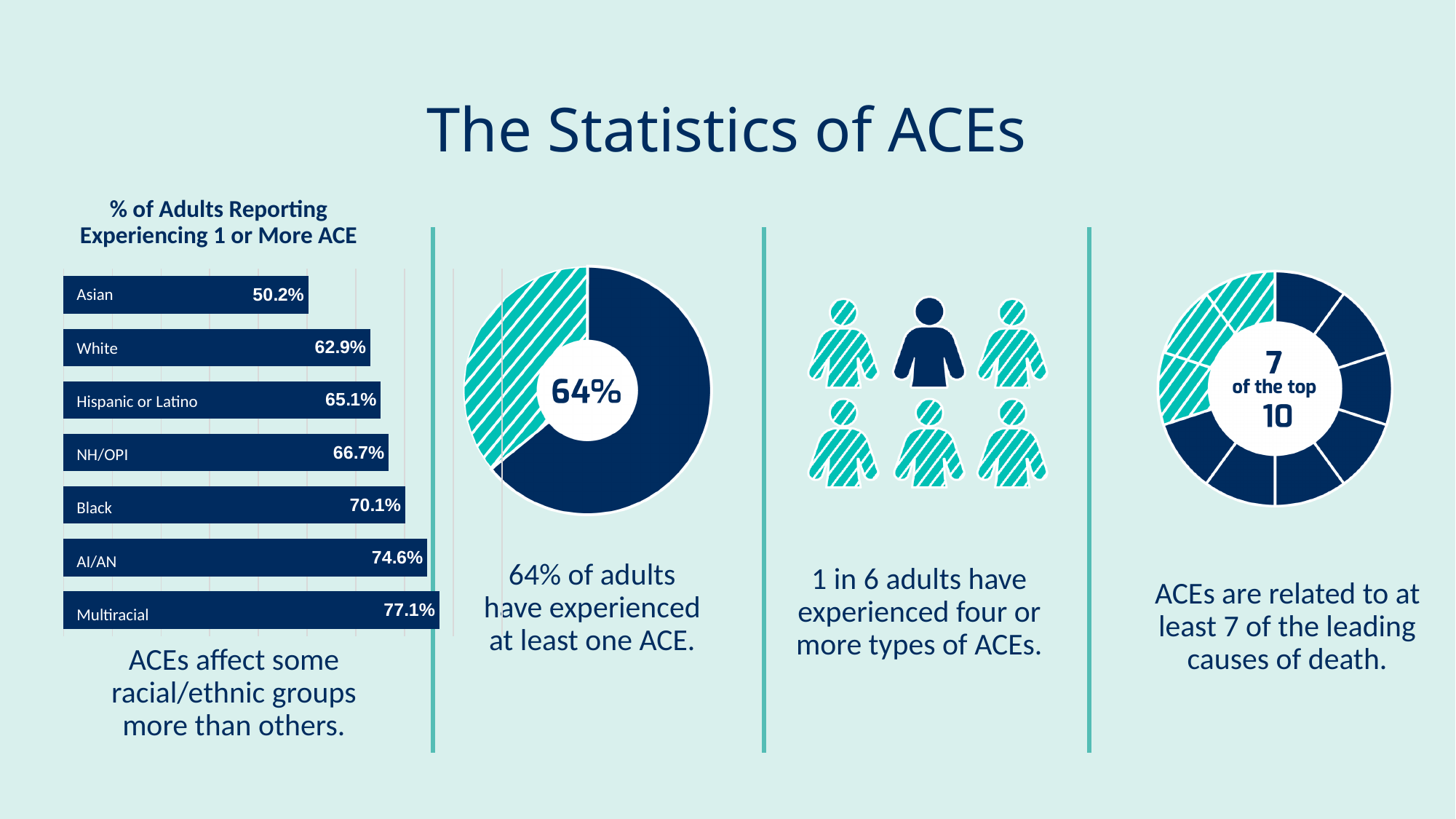
In the bar chart '% of Adults Reporting Experiencing 1 or More ACE', which is larger, the value for White or the value for Hispanic or Latino? Hispanic or Latino What kind of chart is '% of Adults Reporting Experiencing 1 or More ACE'? Bar chart In the bar chart '% of Adults Reporting Experiencing 1 or More ACE', which group has the highest value? Multiracial In the bar chart '% of Adults Reporting Experiencing 1 or More ACE', what is the value for Black? 70.1% In the bar chart '% of Adults Reporting Experiencing 1 or More ACE', what is the difference between the values for Multiracial and Asian? 26.9% In the bar chart '% of Adults Reporting Experiencing 1 or More ACE', what is the difference between the values for AI/AN and Black? 4.5% In the bar chart '% of Adults Reporting Experiencing 1 or More ACE', what is the value for NH/OPI? 66.7% What is the title of the bar chart on the left of the slide? % of Adults Reporting Experiencing 1 or More ACE How many racial/ethnic groups are shown in the bar chart '% of Adults Reporting Experiencing 1 or More ACE'? 7 In the bar chart '% of Adults Reporting Experiencing 1 or More ACE', what is the value for Asian? 50.2% In the donut chart in the second panel, what percentage of adults have experienced at least one ACE? 64% In the bar chart '% of Adults Reporting Experiencing 1 or More ACE', which group has the lowest value? Asian